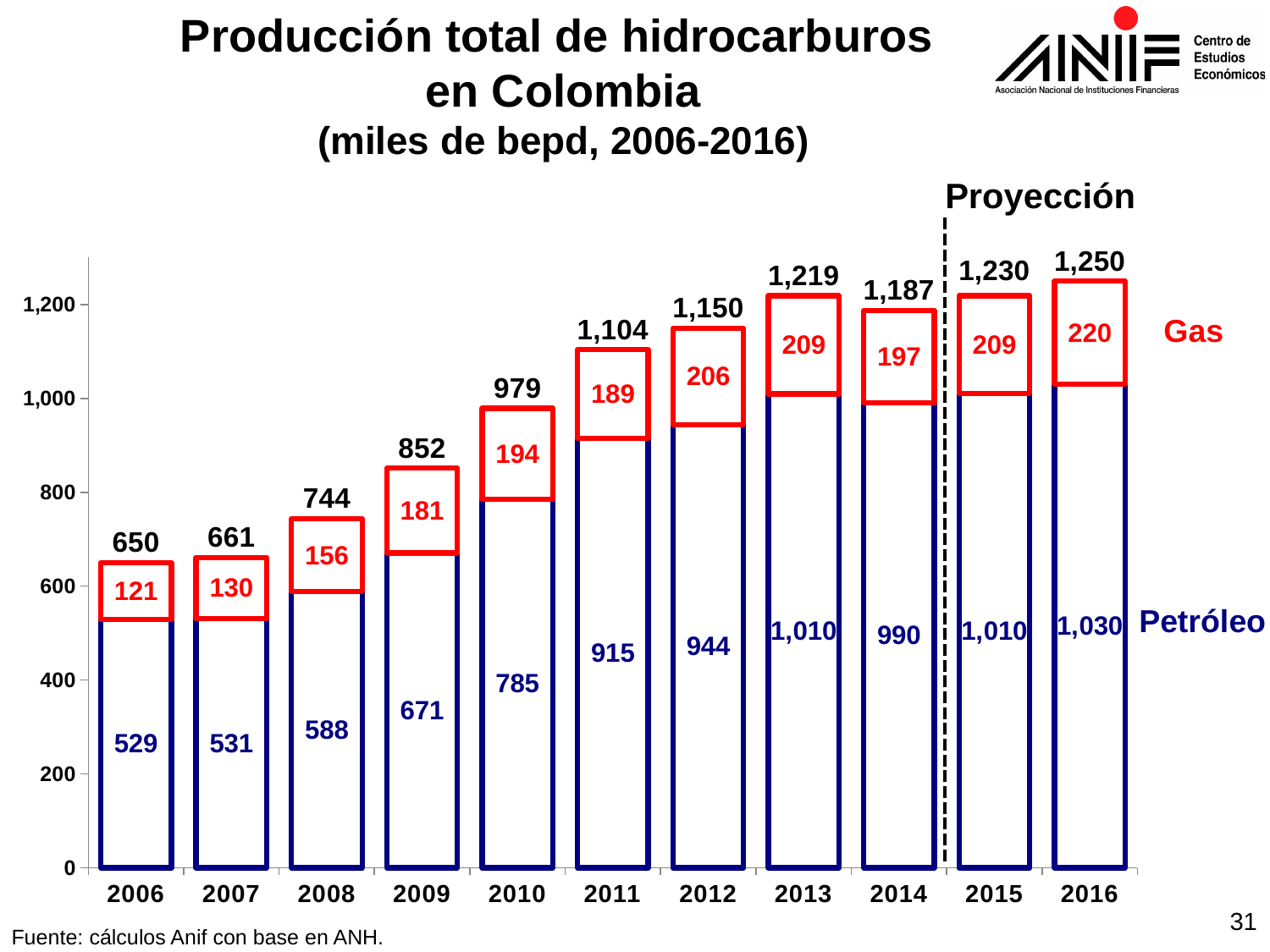
What is the Gas value for 2012? 206 Does total production generally rise or fall from 2006 to 2016? Rise Which year has the highest total production? 2016 What is the Petróleo value for 2010? 785 Which year has the larger Gas value, 2010 or 2011? 2010 What kind of chart is shown on the slide? Stacked bar chart Which years are marked as projections (Proyección)? 2015 and 2016 What is the total hydrocarbon production shown for 2013? 1,219 Which year has the lowest total production? 2006 How many series does the chart show? 2 What is the difference between the Petróleo values for 2013 and 2014? 20 How many years are shown on the x axis? 11